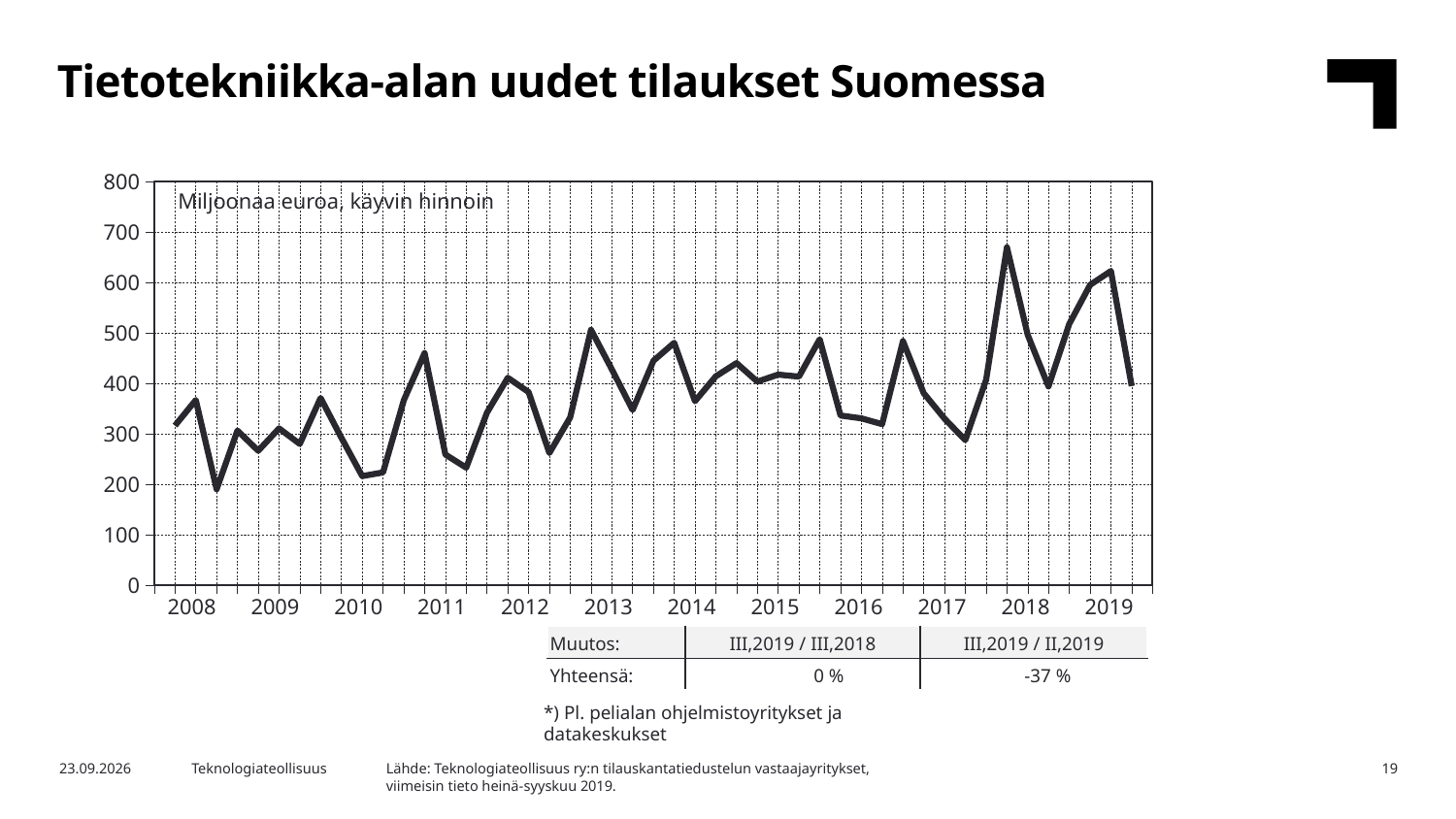
What is the title of the chart? Tietotekniikka-alan uudet tilaukset Suomessa Is the lowest point of the line, in 2008, greater or less than 300? less What kind of chart is shown on the slide? line chart Is the low point of the line in 2017 greater or less than 400? less How many years are labelled on the x axis? 12 What unit label is printed inside the chart area? Miljoonaa euroa, käyvin hinnoin According to the table below the chart, what is the change for III,2019 / II,2019? -37 % Is the peak reached in 2019 greater or less than 500? greater Does the line rise or fall from its low point in 2017 to its peak in 2018? rise In which year does the line reach its highest peak? 2018 What is the highest value shown on the y axis? 800